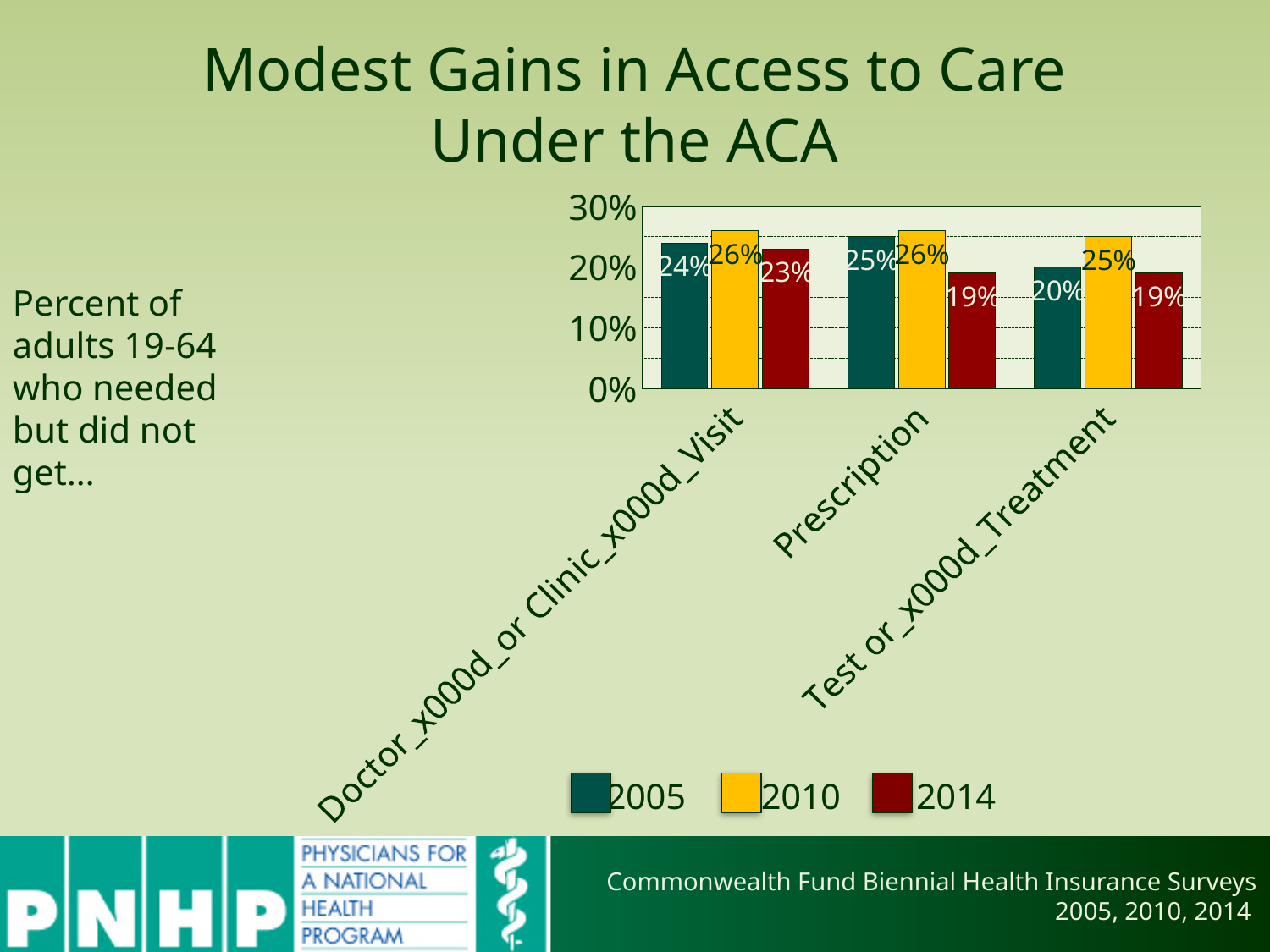
How many categories are shown on the x axis? 3 What is the 2014 value for Prescription? 19% Which year has the highest value for Prescription? 2010 How many series does the legend list? 3 Which series is shown in yellow in the legend? 2010 Which is larger for the Doctor or Clinic Visit category, the 2005 value or the 2014 value? 2005 What is the difference between the 2010 and 2014 values for Prescription? 7% What is the 2010 value for the Doctor or Clinic Visit category? 26% Is the 2010 value for the Test or Treatment category greater or less than 20%? greater What type of chart is shown on the slide? bar chart What is the 2005 value for the Test or Treatment category? 20% Which year has the lowest value for the Test or Treatment category? 2014